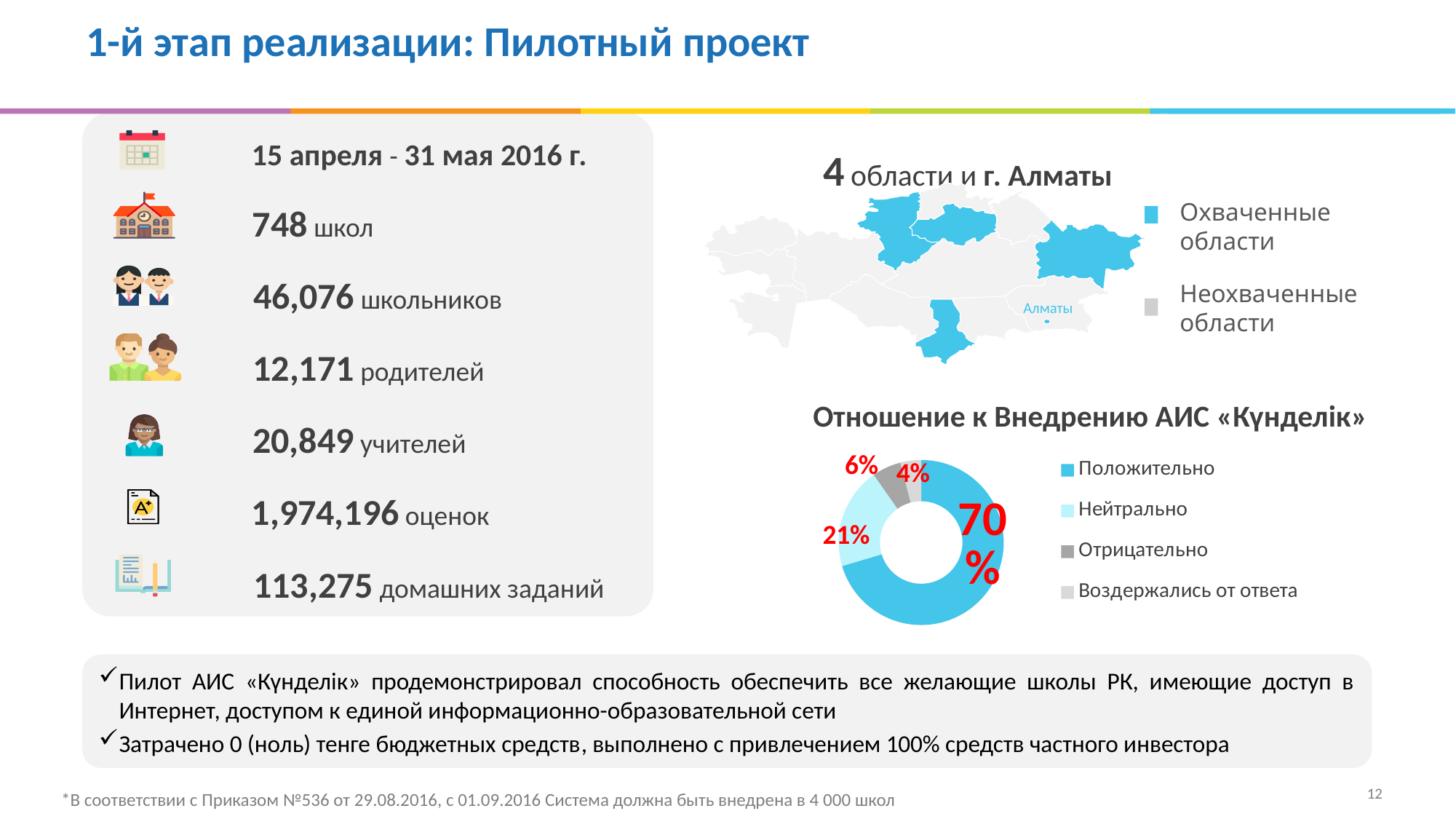
In the chart «Отношение к Внедрению АИС «Күнделік»», what is the smallest percentage shown on any slice? 4% In the chart «Отношение к Внедрению АИС «Күнделік»», which is larger: Положительно or Нейтрально? Положительно What kind of chart is shown under the title «Отношение к Внедрению АИС «Күнделік»»? doughnut chart In the chart «Отношение к Внедрению АИС «Күнделік»», what share is labelled for Положительно? 70% In the legend of the chart «Отношение к Внедрению АИС «Күнделік»», which entry is listed last? Воздержались от ответа In the chart «Отношение к Внедрению АИС «Күнделік»», what are the four percentage labels shown on the slices? 70%, 21%, 6%, 4% How many slices does the chart «Отношение к Внедрению АИС «Күнделік»» have? 4 In the chart «Отношение к Внедрению АИС «Күнделік»», which category has the largest share? Положительно In the chart «Отношение к Внедрению АИС «Күнделік»», what share is labelled for Нейтрально? 21% In the chart «Отношение к Внедрению АИС «Күнделік»», how many percentage points larger is Положительно than Нейтрально? 49 What is the title of the pie chart on the slide? Отношение к Внедрению АИС «Күнделік» How many entries does the legend of the chart «Отношение к Внедрению АИС «Күнделік»» list? 4